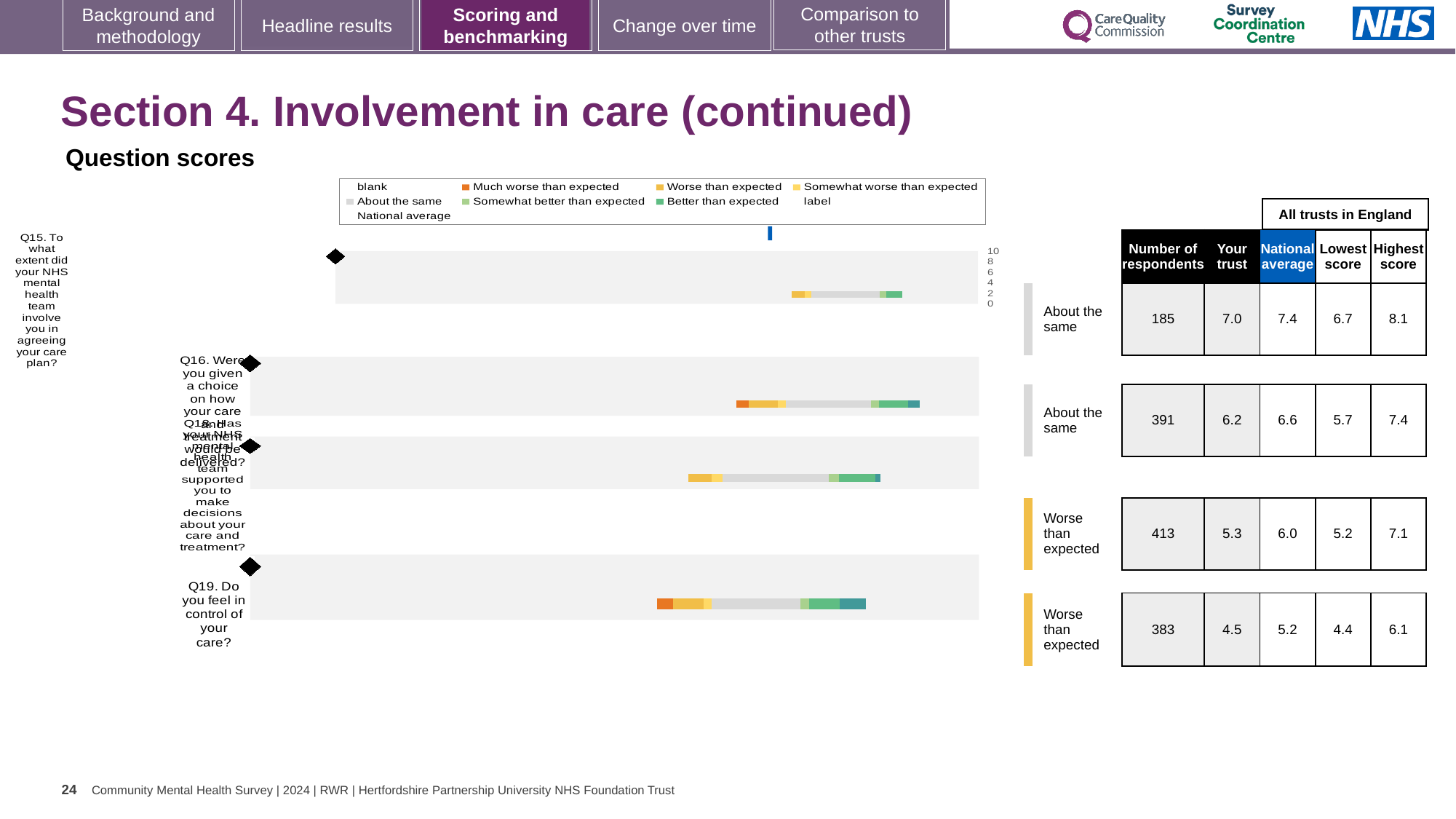
Which question has the highest 'Your trust' score? Q15 What is the national average score for Q16 (choice on how care and treatment would be delivered)? 6.6 How many questions (categories) are plotted in the question scores chart? 4 Is the 'Your trust' score for Q16 larger or smaller than the national average for Q16? smaller What kind of chart is used to show the question scores on this slide? bar chart What is the highest value shown on the chart's axis? 10 What is the number of respondents for Q18 (supported you to make decisions about your care and treatment)? 413 What is the difference between the national average and the 'Your trust' score for Q18? 0.7 What is the 'Your trust' score for Q15 (involving you in agreeing your care plan)? 7.0 Which question has the lowest 'Your trust' score? Q19 What is the 'Your trust' score for Q19 (feeling in control of your care)? 4.5 Which legend entry is shown in orange in the question scores chart? Much worse than expected